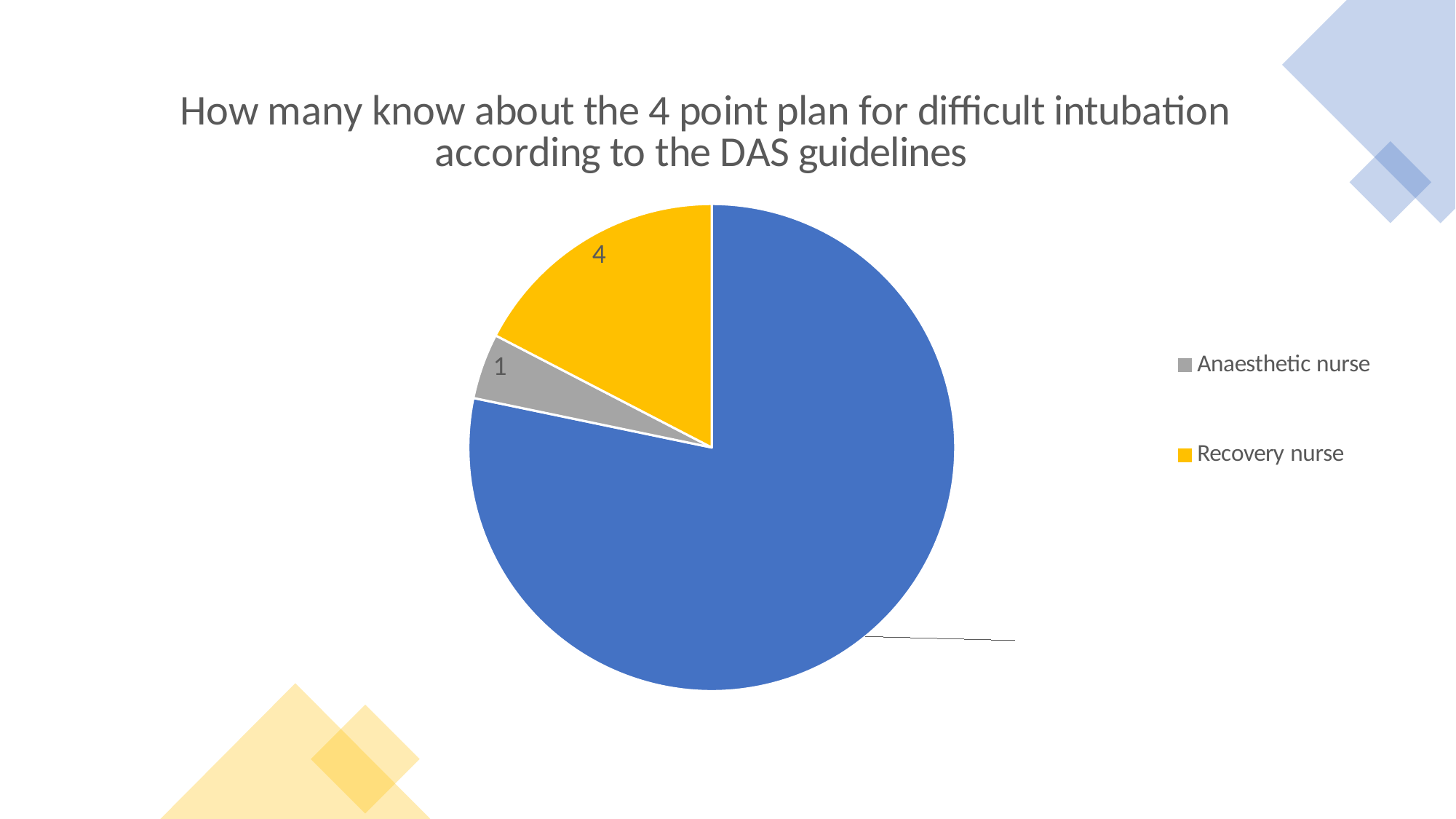
What colour is the Recovery nurse slice? yellow Which has the larger value, Recovery nurse or Anaesthetic nurse? Recovery nurse What is the title of the chart? How many know about the 4 point plan for difficult intubation according to the DAS guidelines What is the value shown for Anaesthetic nurse? 1 Of the two categories listed in the legend, which has the smaller slice? Anaesthetic nurse What is the value shown for Recovery nurse? 4 How many entries does the legend list? 2 What is the difference between the values for Recovery nurse and Anaesthetic nurse? 3 What kind of chart is shown on the slide? pie chart How many slices does the pie chart have? 3